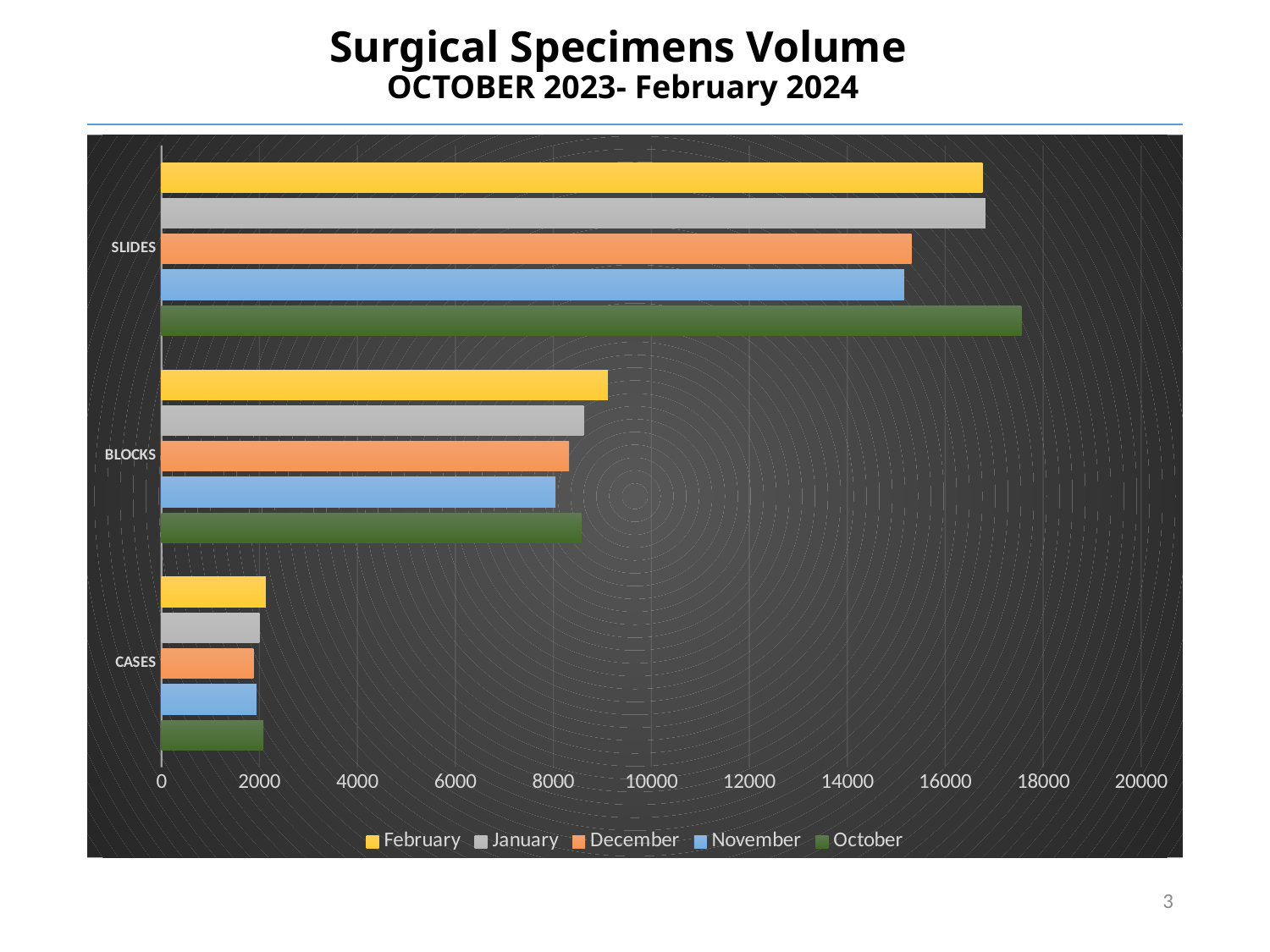
What kind of chart is shown on the slide? Bar chart In the SLIDES category, which is larger: the value for October or the value for November? October Is the value for February in the BLOCKS category greater or less than 10000? less What is the title of the chart on the slide? Surgical Specimens Volume OCTOBER 2023- February 2024 Is the value for October in the SLIDES category greater or less than 16000? greater Is the value for February in the CASES category greater or less than 4000? less How many categories are shown on the vertical axis of the chart? 3 Which month has the highest value in the BLOCKS category? February How many series does the legend list? 5 Which month has the highest value in the SLIDES category? October